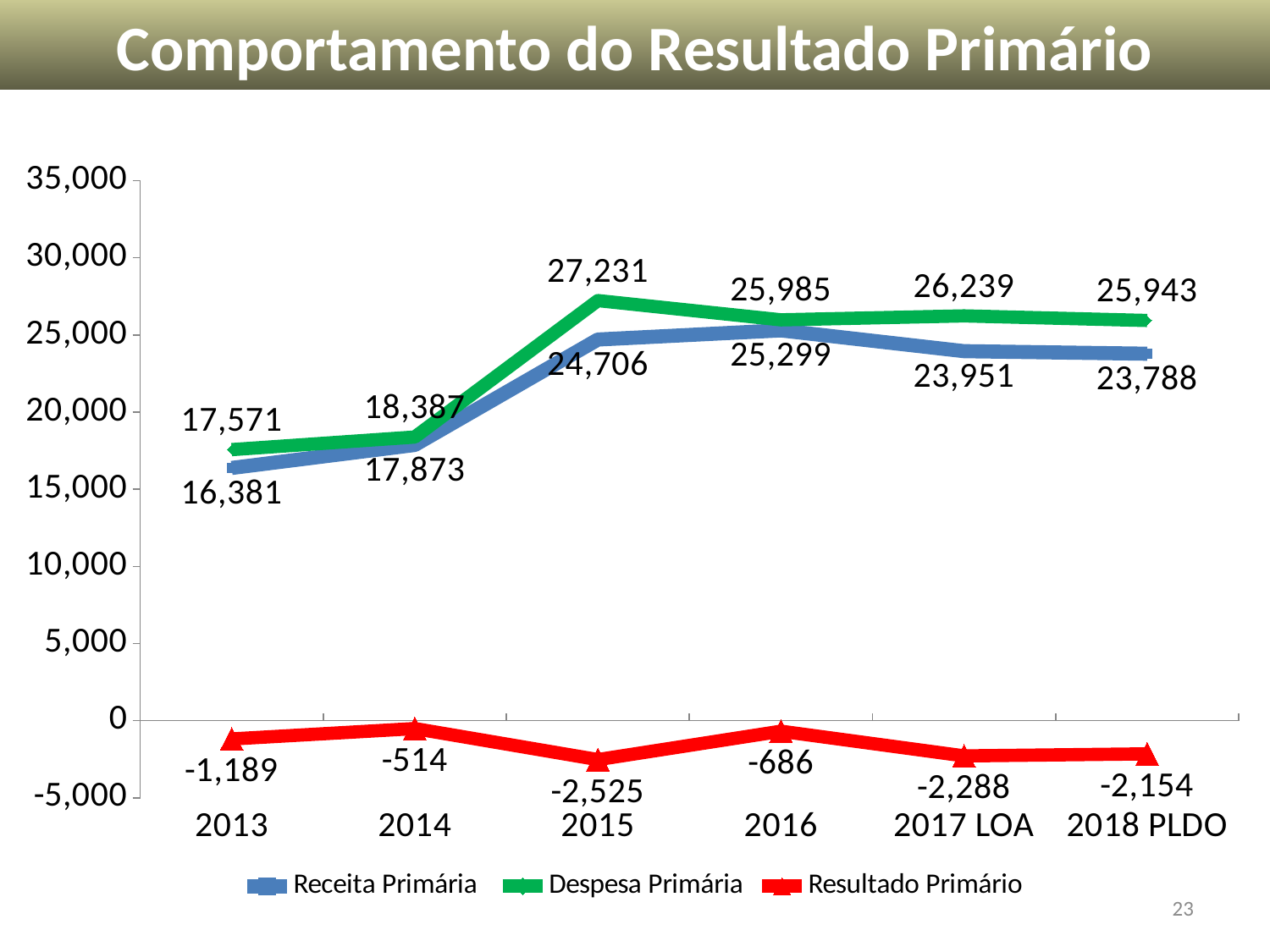
How many categories are shown on the x axis? 6 In which year is Despesa Primária highest? 2015 What is the value of Despesa Primária in 2015? 27,231 What is the difference between Despesa Primária and Receita Primária in 2015? 2,525 What is the value of Resultado Primário in 2017 LOA? -2,288 What is the value of Receita Primária in 2018 PLDO? 23,788 In which year is Receita Primária highest? 2016 How many series does the legend list? 3 Which is larger in 2014, Receita Primária or Despesa Primária? Despesa Primária What kind of chart is shown on the slide? Line chart What is the value of Receita Primária in 2013? 16,381 In which year is Resultado Primário lowest? 2015